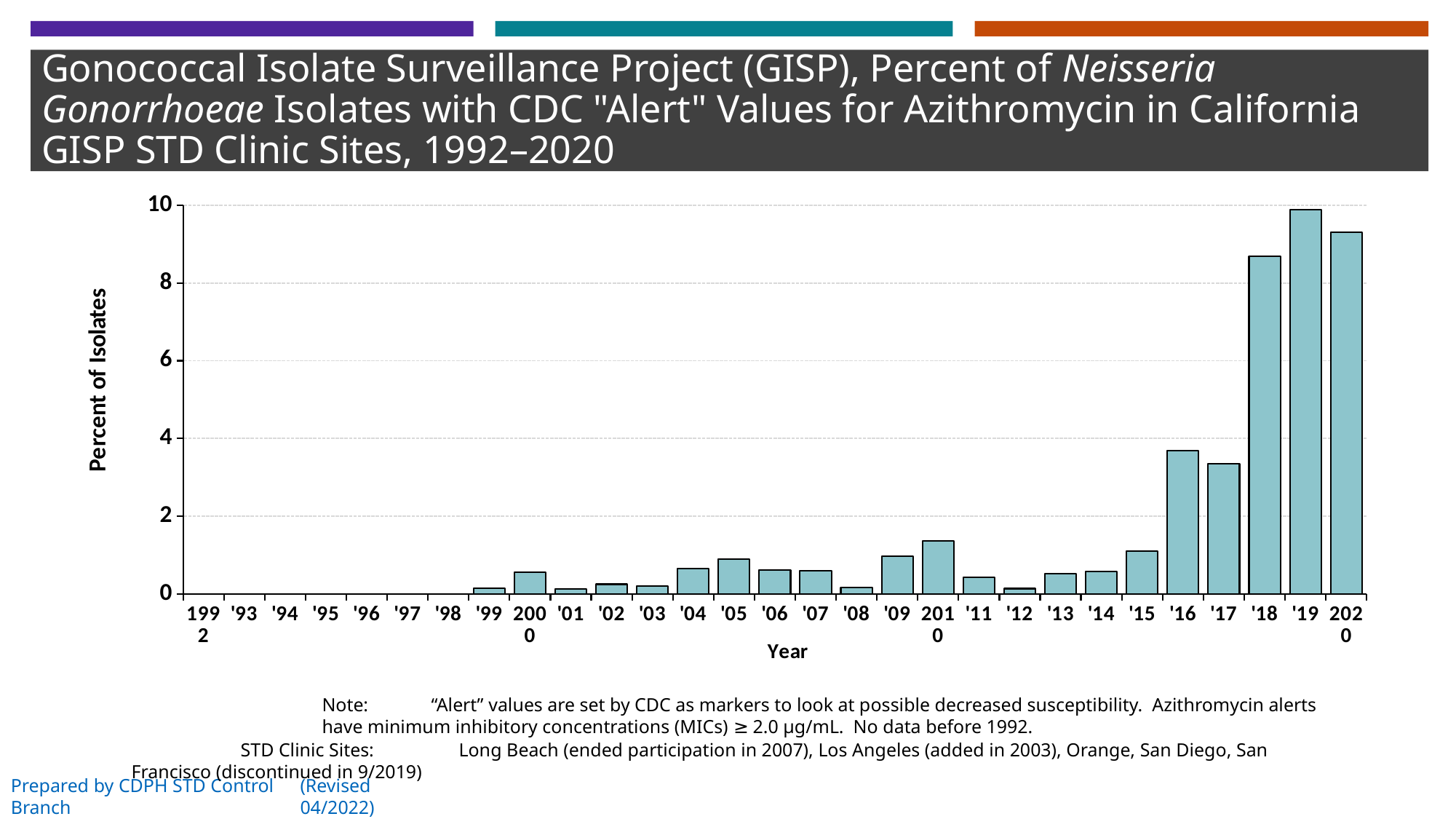
Which year has the larger value, 2016 or 2017? 2016 Is the value for 2020 greater or less than 8? greater Is the value for 2017 greater or less than 2? greater Which year has the highest percent of isolates with azithromycin alert values? 2019 Is the value for 2010 greater or less than 2? less What kind of chart is shown on the slide? bar chart Do the values generally rise or fall from 2017 to 2019? rise What is the label of the y axis? Percent of Isolates Which year has the larger value, 2018 or 2020? 2020 How many years are shown on the x axis of the chart? 29